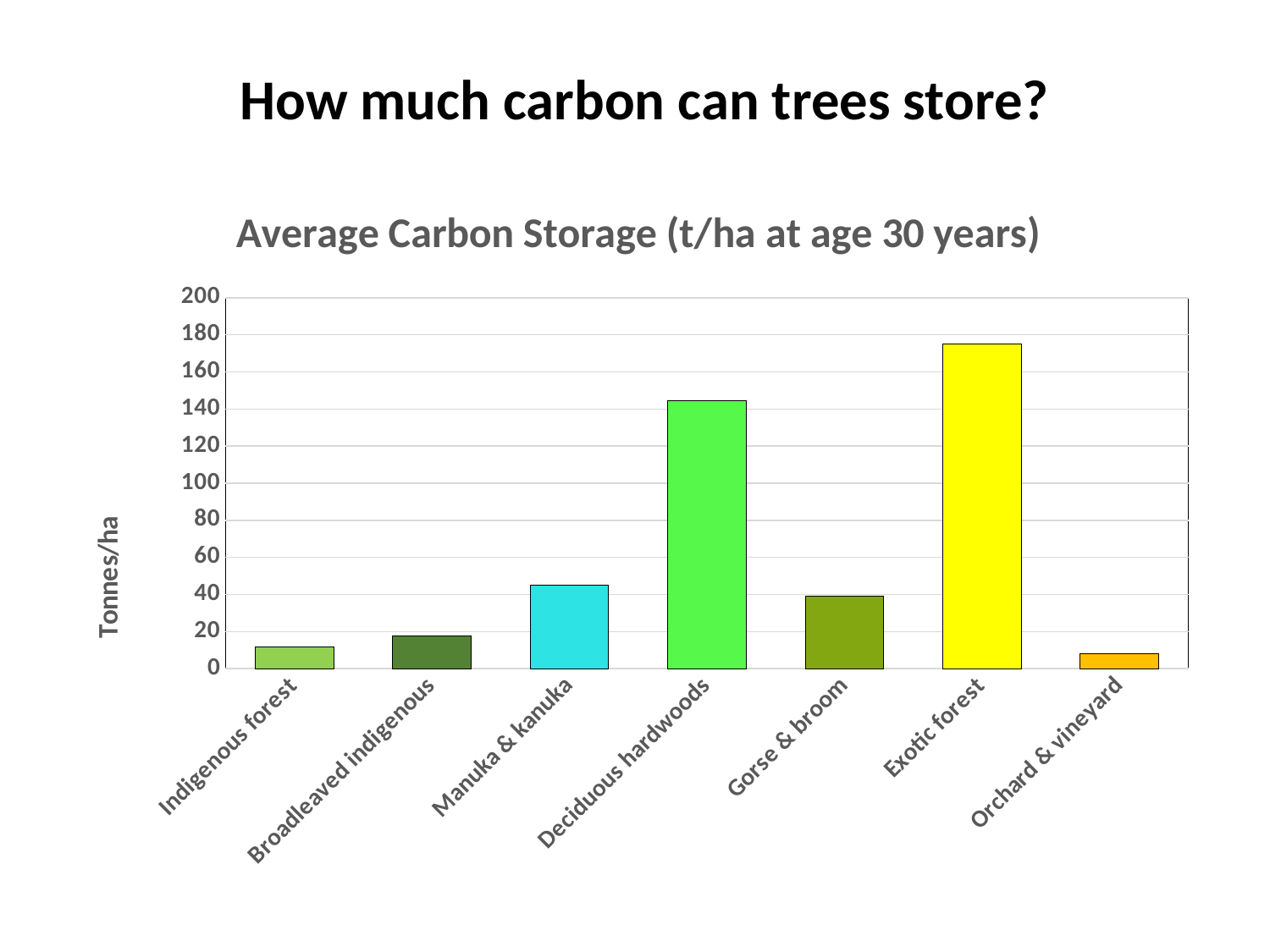
Which is larger, the value for Deciduous hardwoods or the value for Gorse & broom? Deciduous hardwoods What is the label on the y axis? Tonnes/ha How many categories are shown on the x axis? 7 What type of chart is shown on the slide? bar chart Is the value for Indigenous forest greater or less than 20? less Which is larger, the value for Broadleaved indigenous or the value for Indigenous forest? Broadleaved indigenous Is the value for Manuka & kanuka greater or less than 60? less What is the title of the chart? Average Carbon Storage (t/ha at age 30 years) Is the value for Exotic forest greater or less than 160? greater Which category has the lowest average carbon storage? Orchard & vineyard Which category has the highest average carbon storage? Exotic forest